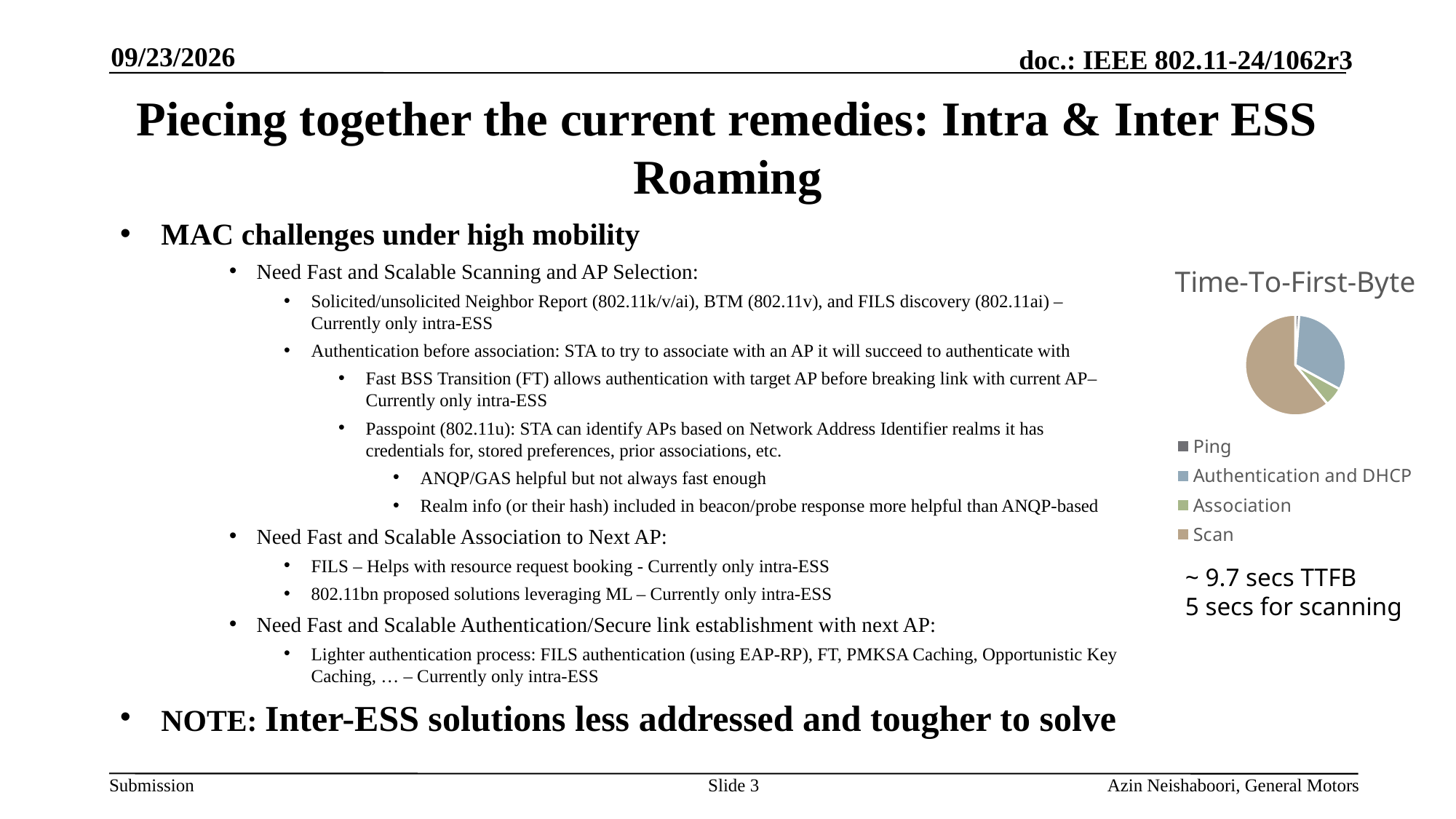
How many categories does the legend of the Time-To-First-Byte chart list? 4 In the Time-To-First-Byte chart, which slice is larger: Authentication and DHCP or Association? Authentication and DHCP Which category takes the largest share of the Time-To-First-Byte pie chart? Scan In the Time-To-First-Byte chart, which slice is larger: Association or Ping? Association How many slices does the Time-To-First-Byte pie chart have? 4 Which legend entry in the Time-To-First-Byte chart is shown in green? Association In the Time-To-First-Byte chart, which slice is larger: Scan or Authentication and DHCP? Scan What kind of chart is shown on the slide? pie chart What is the title of the chart? Time-To-First-Byte Which category takes the smallest share of the Time-To-First-Byte pie chart? Ping